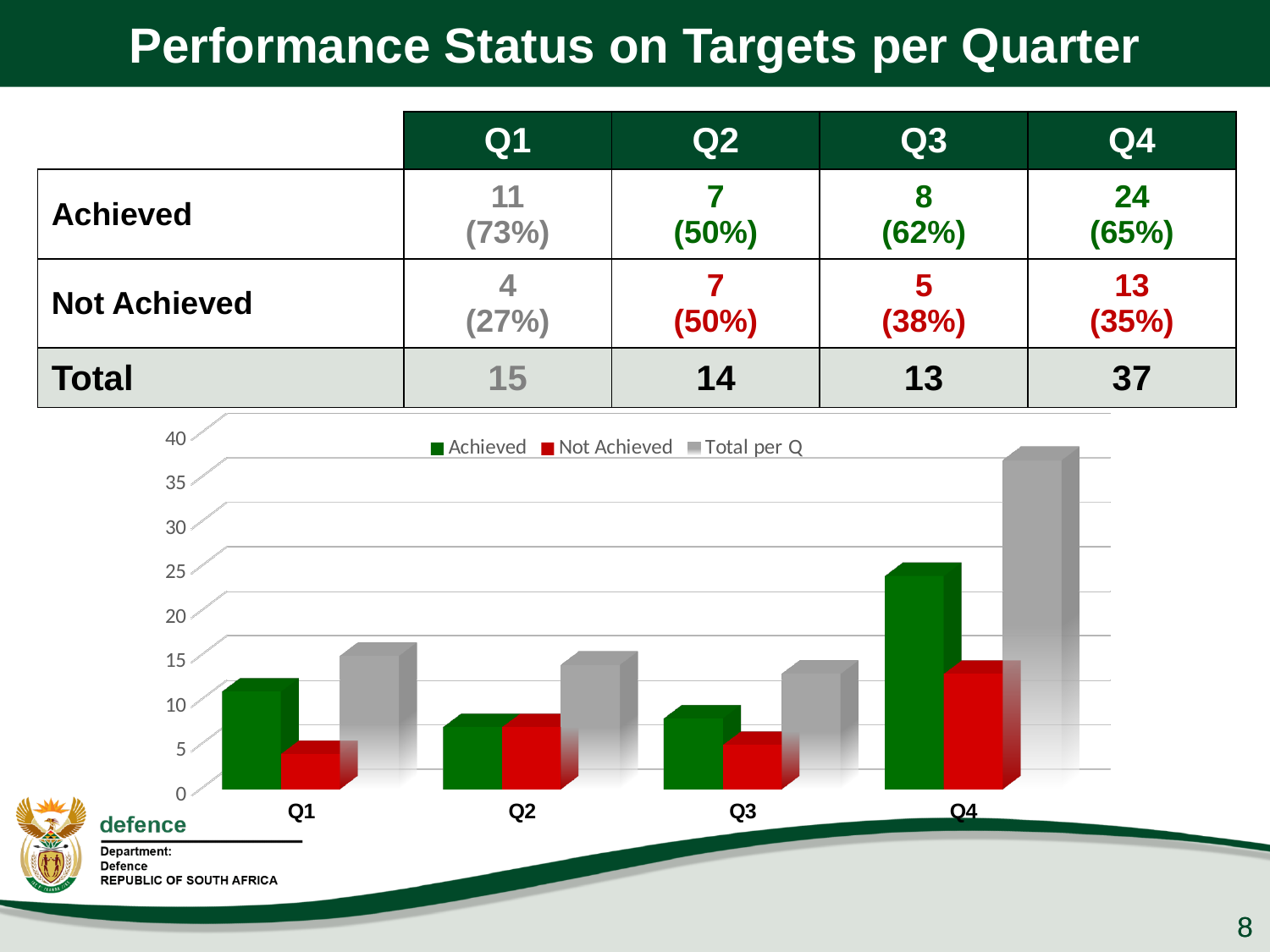
What is the difference between the Achieved and Not Achieved values in Q4? 11 Which quarter has the lowest Total per Q value? Q3 How many series does the chart legend list? 3 How many quarters are shown on the x axis of the chart? 4 What kind of chart is shown on the slide? bar chart Which is larger in Q3, the Achieved value or the Not Achieved value? Achieved Is the Total per Q value for Q4 greater or less than 35? greater Is the Achieved value for Q2 greater or less than 10? less What is the Achieved value for Q4? 24 What is the Not Achieved value for Q1? 4 What colour represents the Not Achieved series in the chart? red Which quarter has the highest Achieved value? Q4